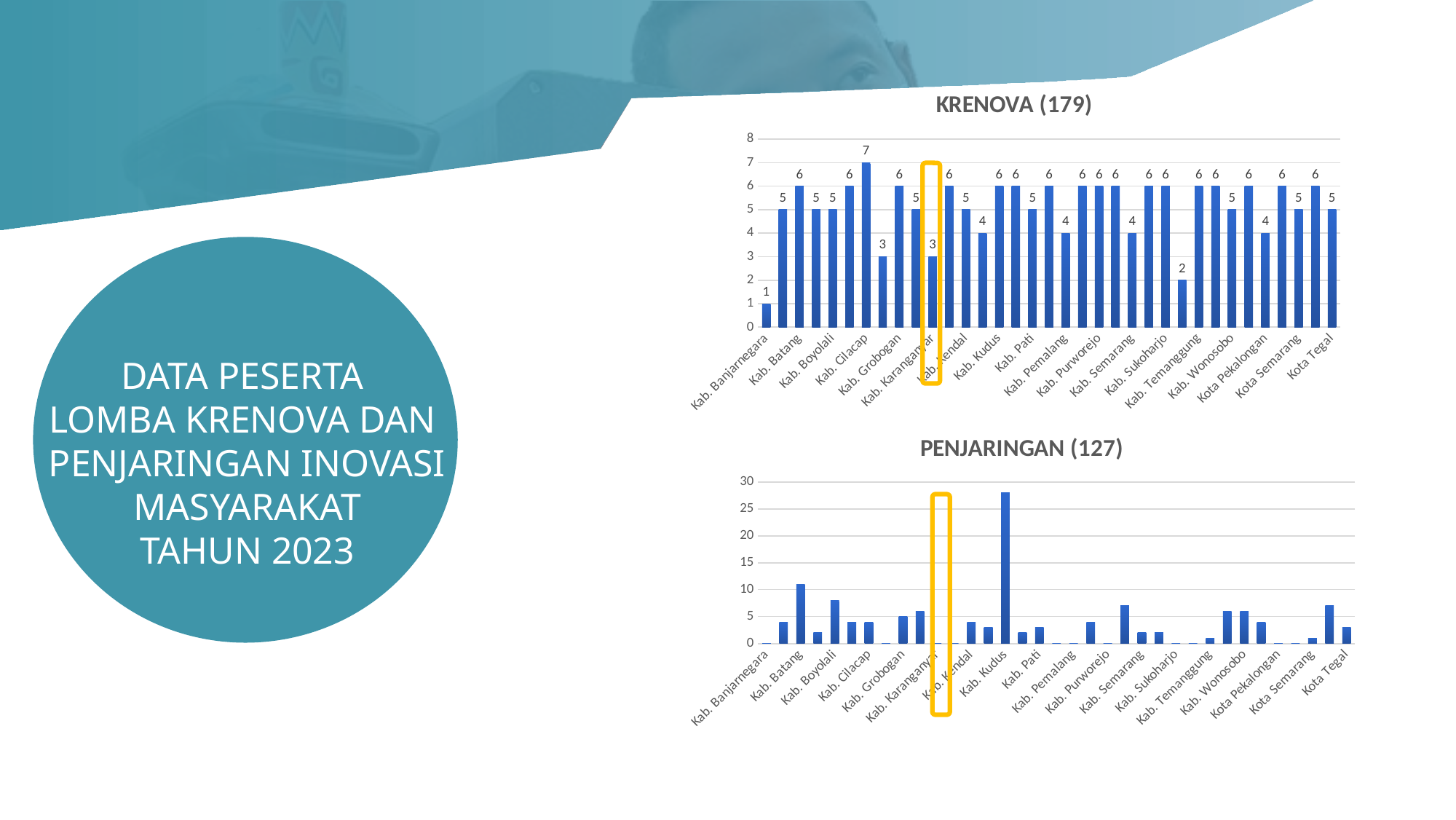
In the KRENOVA (179) chart, what is the difference between the values for Kab. Cilacap and Kab. Banjarnegara? 6 In the KRENOVA (179) chart, what is the value for Kab. Banjarnegara? 1 In the KRENOVA (179) chart, what is the value for Kab. Cilacap? 7 In the KRENOVA (179) chart, what is the value for Kab. Karanganyar? 3 In the KRENOVA (179) chart, which category has the highest value? Kab. Cilacap In the PENJARINGAN (127) chart, is the value for Kab. Boyolali greater or less than 10? less In the PENJARINGAN (127) chart, which is larger, the value for Kab. Kudus or the value for Kab. Batang? Kab. Kudus What kind of chart is the PENJARINGAN (127) chart? bar chart In the KRENOVA (179) chart, which category has the lowest value? Kab. Banjarnegara In the PENJARINGAN (127) chart, is the value for Kab. Kudus greater or less than 25? greater In the PENJARINGAN (127) chart, which category has the highest value? Kab. Kudus In the KRENOVA (179) chart, which is larger, the value for Kab. Batang or the value for Kab. Karanganyar? Kab. Batang